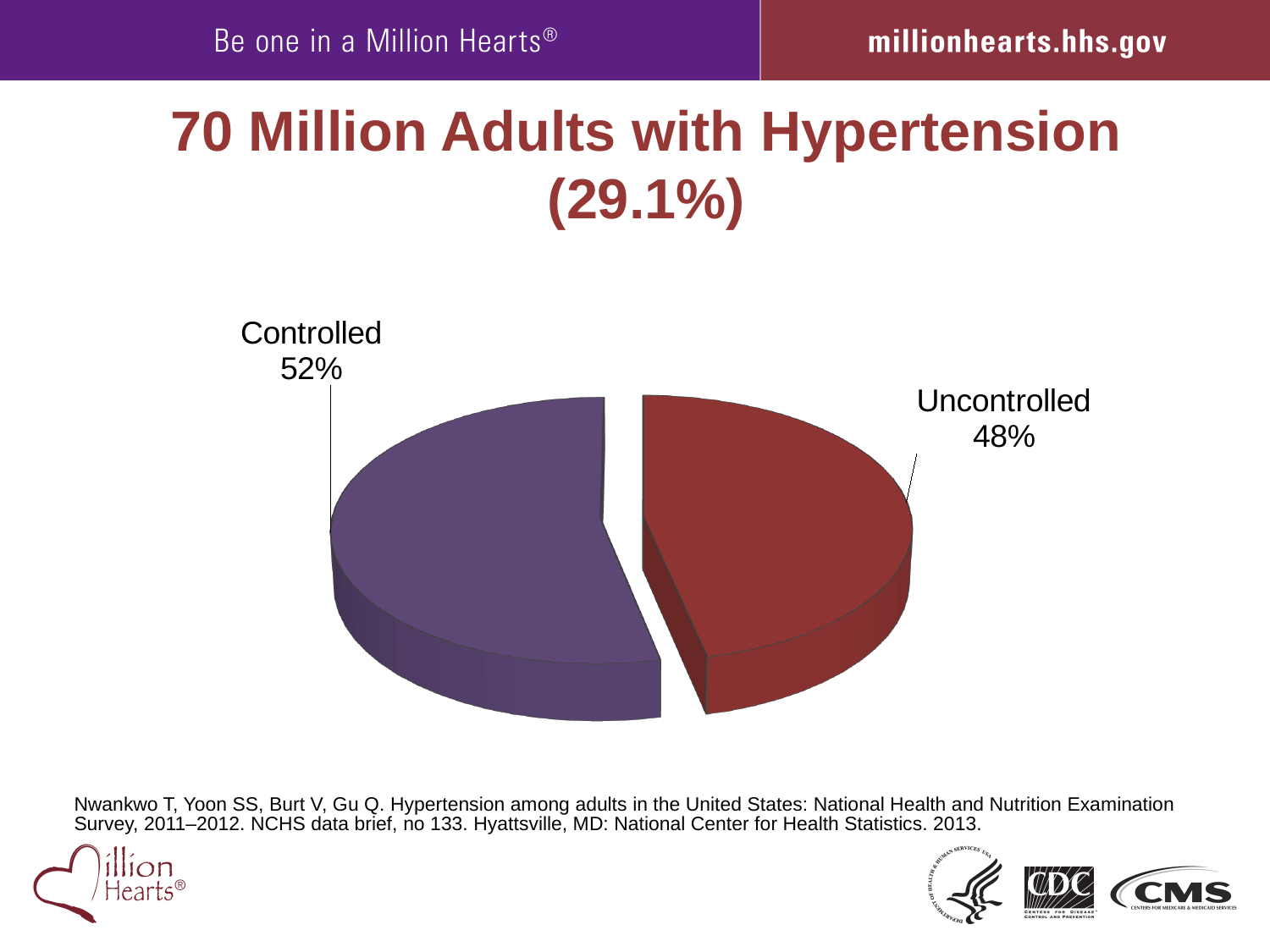
What kind of chart is shown on the slide? Pie chart What is the title of the slide containing the chart? 70 Million Adults with Hypertension (29.1%) What percentage of adults with hypertension are Controlled? 52% What percentage of adults with hypertension are Uncontrolled? 48% What is the difference in percentage points between the Controlled and Uncontrolled slices? 4 Which category has the smallest share of the pie? Uncontrolled Which category has the largest share of the pie? Controlled How many slices does the pie chart have? 2 What colour is the Uncontrolled slice of the pie? Red Which slice of the pie is larger, Controlled or Uncontrolled? Controlled What share of the pie does the Uncontrolled slice represent? 48%